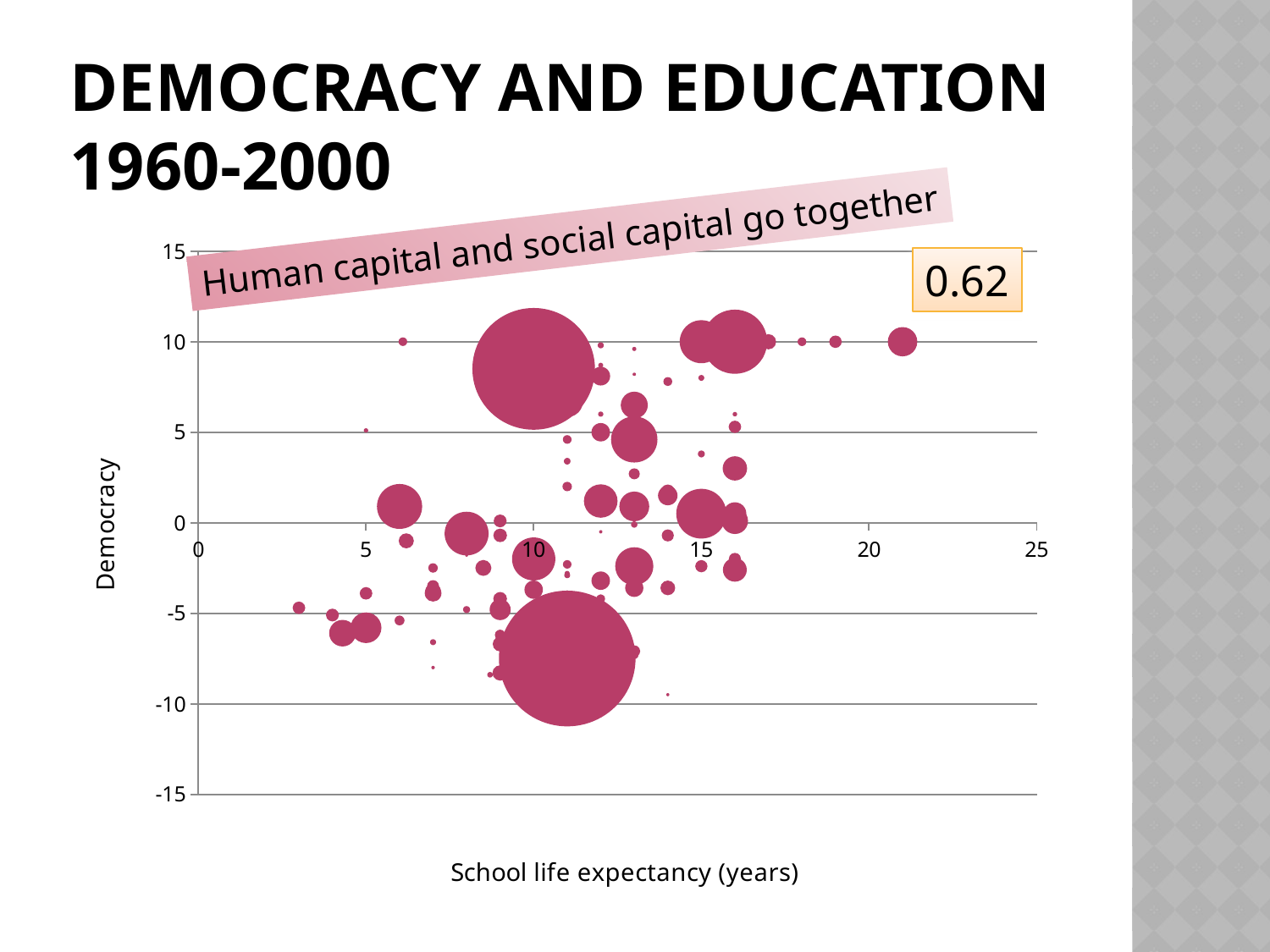
What number is shown in the box in the upper right corner of the chart? 0.62 What democracy value does the rightmost bubble on the chart sit on? 10 What is the highest value shown on the x axis of the chart? 25 As school life expectancy increases along the x axis, do the democracy values generally rise or fall? rise What is the lowest value shown on the y axis of the chart? -15 Is the school life expectancy of the largest bubble on the chart greater or less than 10? greater Is the democracy value of the largest bubble on the chart greater or less than -5? less What is the title of the y axis of the chart? Democracy What is the title of the x axis of the chart? School life expectancy (years) Is the school life expectancy of the rightmost bubble greater or less than 20? greater What kind of chart is shown on the slide? bubble chart